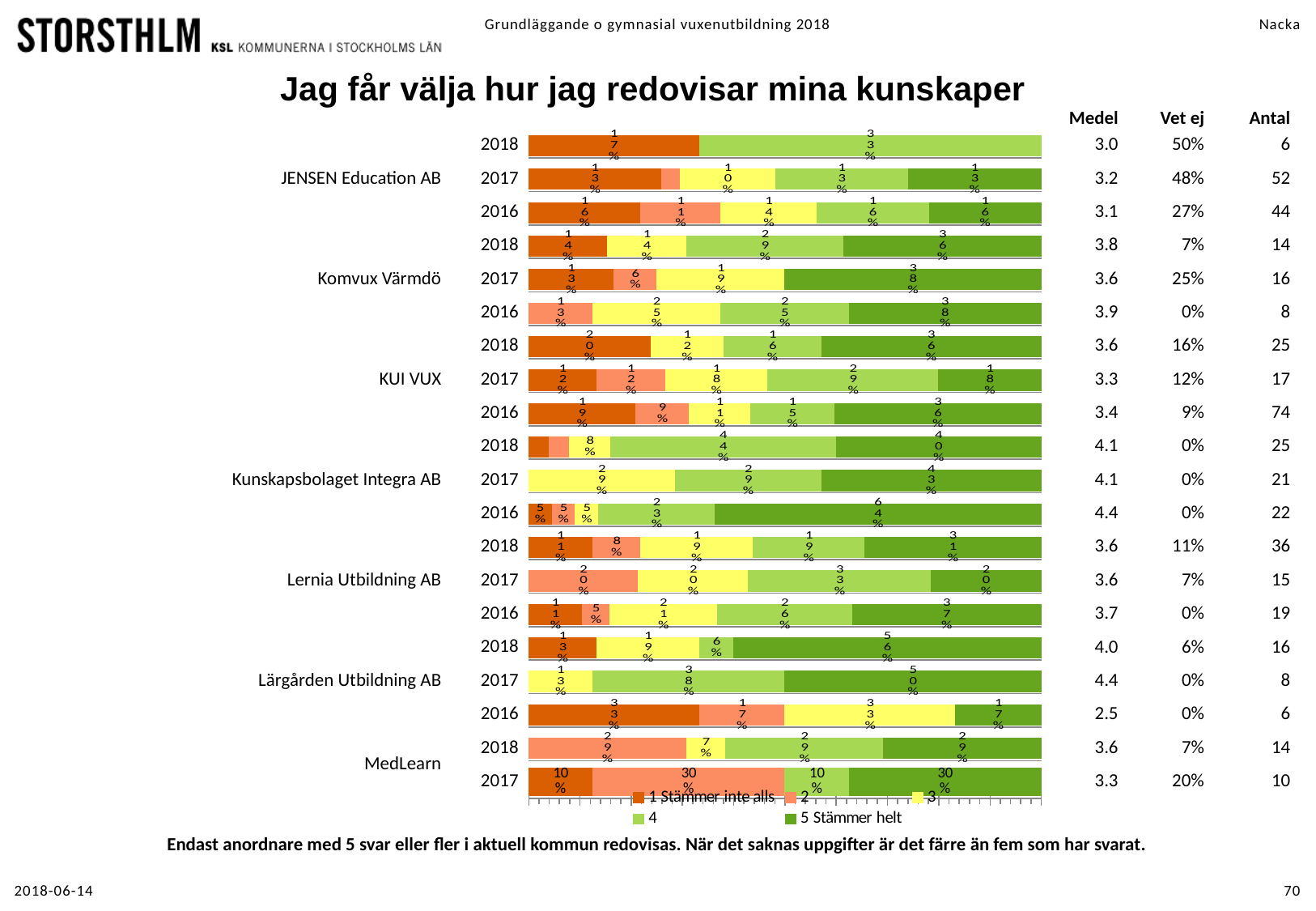
What is the value of the '1 Stämmer inte alls' segment for KUI VUX in 2018? 20% What is the Antal value for KUI VUX in 2016? 74 Which is larger for Lernia Utbildning AB in 2018: the '5 Stämmer helt' segment or the '1 Stämmer inte alls' segment? 5 Stämmer helt What kind of chart is shown on the slide? Stacked bar chart What is the value of the '1 Stämmer inte alls' segment for Lärgården Utbildning AB in 2016? 33% How many series does the chart legend list? 5 Which provider and year has the highest Medel value in the table? Kunskapsbolaget Integra AB 2016 and Lärgården Utbildning AB 2017 (4.4) What is the difference between the '5 Stämmer helt' segment for Lärgården Utbildning AB in 2018 and in 2016? 39 percentage points What is the value of the '5 Stämmer helt' segment for Komvux Värmdö in 2018? 36% What is the value of the '5 Stämmer helt' segment for Kunskapsbolaget Integra AB in 2016? 64% What is the value of the '2' segment for MedLearn in 2017? 30% What is the value of the '4' segment for Lärgården Utbildning AB in 2017? 38%